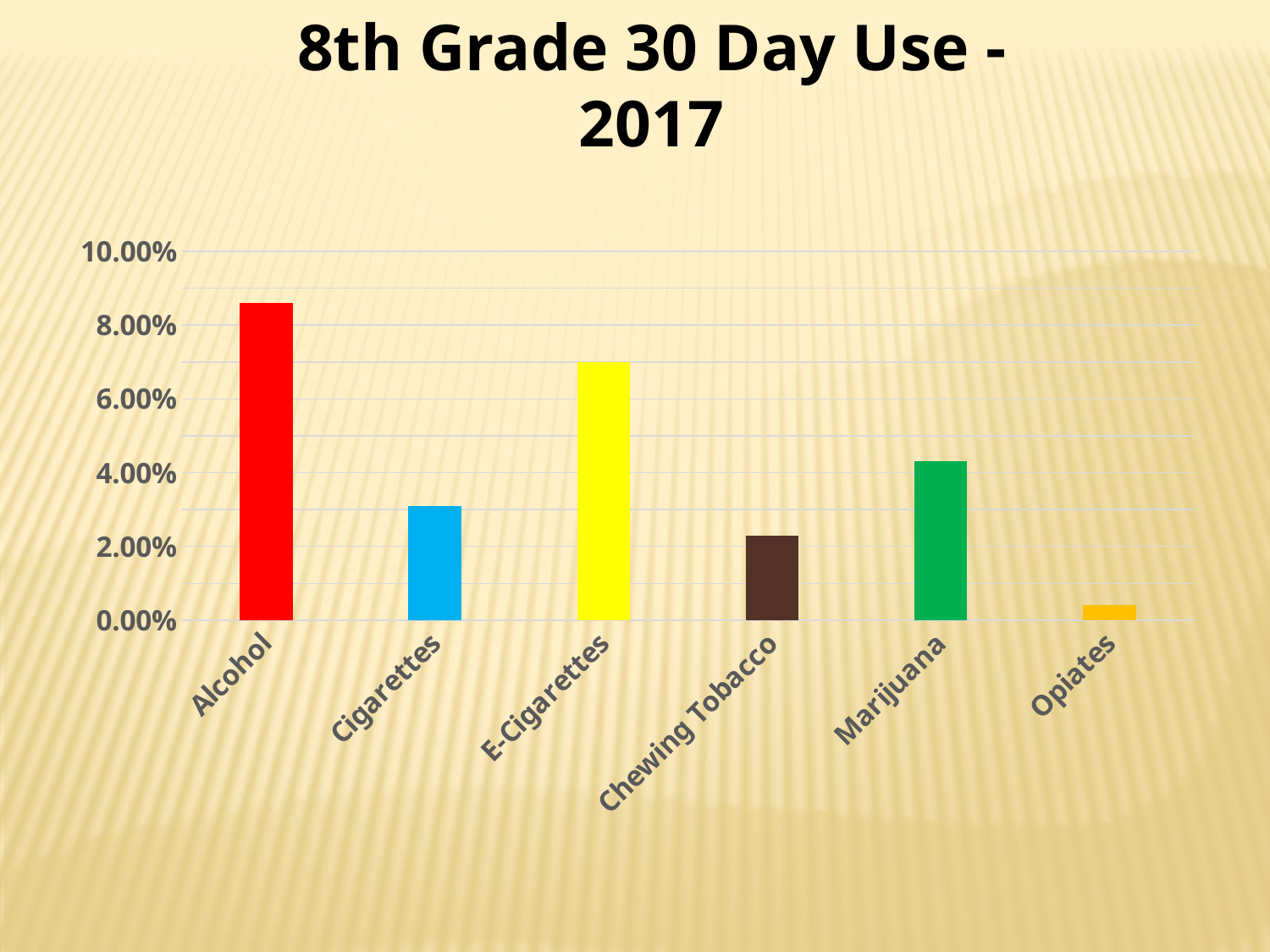
What type of chart is shown on the slide? bar chart Which is larger, the value for E-Cigarettes or the value for Marijuana? E-Cigarettes Which category has the lowest value? Opiates Which category has the highest value? Alcohol Is the value for E-Cigarettes greater or less than 8.00%? less How many categories are shown on the x axis? 6 Is the value for Opiates greater or less than 2.00%? less Which is larger, the value for Cigarettes or the value for Chewing Tobacco? Cigarettes Is the value for Marijuana greater or less than 6.00%? less What is the title of the chart? 8th Grade 30 Day Use - 2017